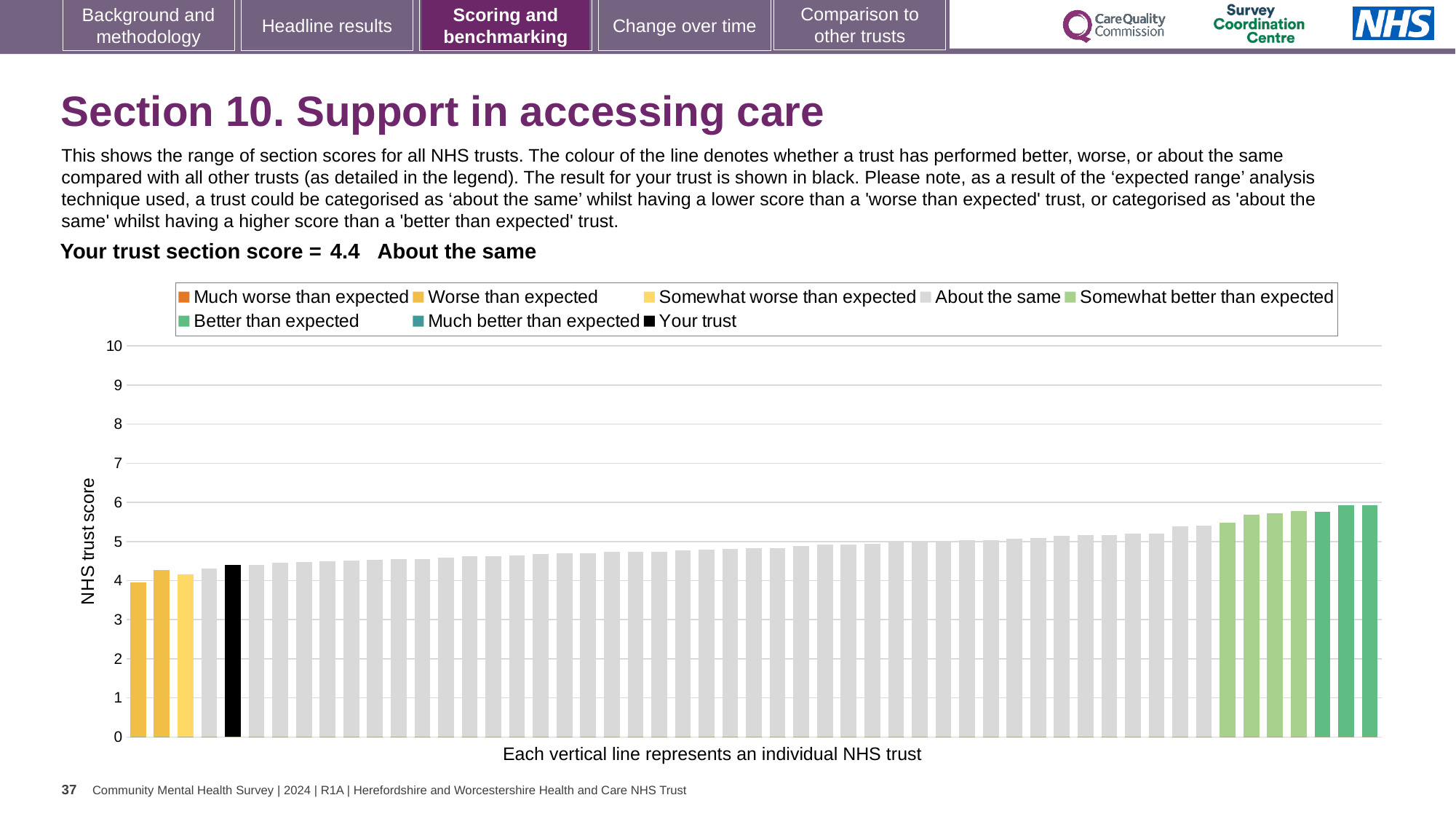
How many bars are coloured as 'Much better than expected' (dark green)? 0 What colour is the bar representing your trust? black Is the value of the black bar (your trust) greater or less than 4? greater What is the label on the vertical axis of the chart? NHS trust score How many entries does the chart legend list? 8 Is the value of the tallest bar greater or less than 7? less What kind of chart is shown on the slide? bar chart Which performance category is your trust placed in for this section? About the same Do the bar values rise or fall from left to right along the x axis? rise Is the value of the black bar (your trust) greater or less than 5? less What is the section score for your trust shown on the slide? 4.4